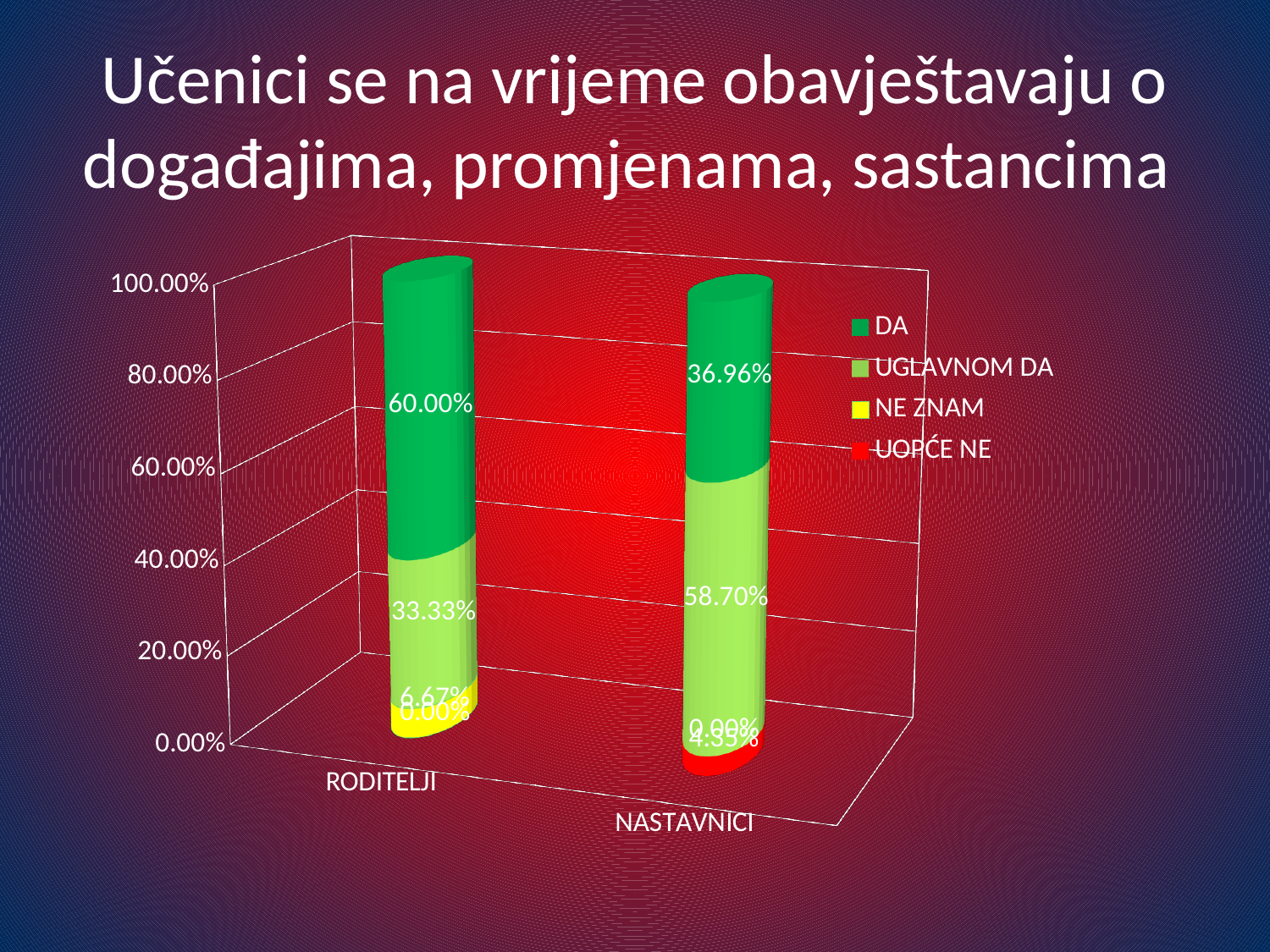
Which series is shown in red in the legend? UOPĆE NE What is the value of UGLAVNOM DA for NASTAVNICI? 58.70% How many series does the legend list? 4 Which category has the higher value for DA, RODITELJI or NASTAVNICI? RODITELJI What is the value of DA for RODITELJI? 60.00% What kind of chart is shown on the slide? stacked bar chart What is the title of the chart? Učenici se na vrijeme obavještavaju o događajima, promjenama, sastancima What is the difference between the DA values for RODITELJI and NASTAVNICI? 23.04% How many categories are shown on the x axis? 2 What is the value of UOPĆE NE for NASTAVNICI? 4.35% What is the value of DA for NASTAVNICI? 36.96% What is the value of UGLAVNOM DA for RODITELJI? 33.33%